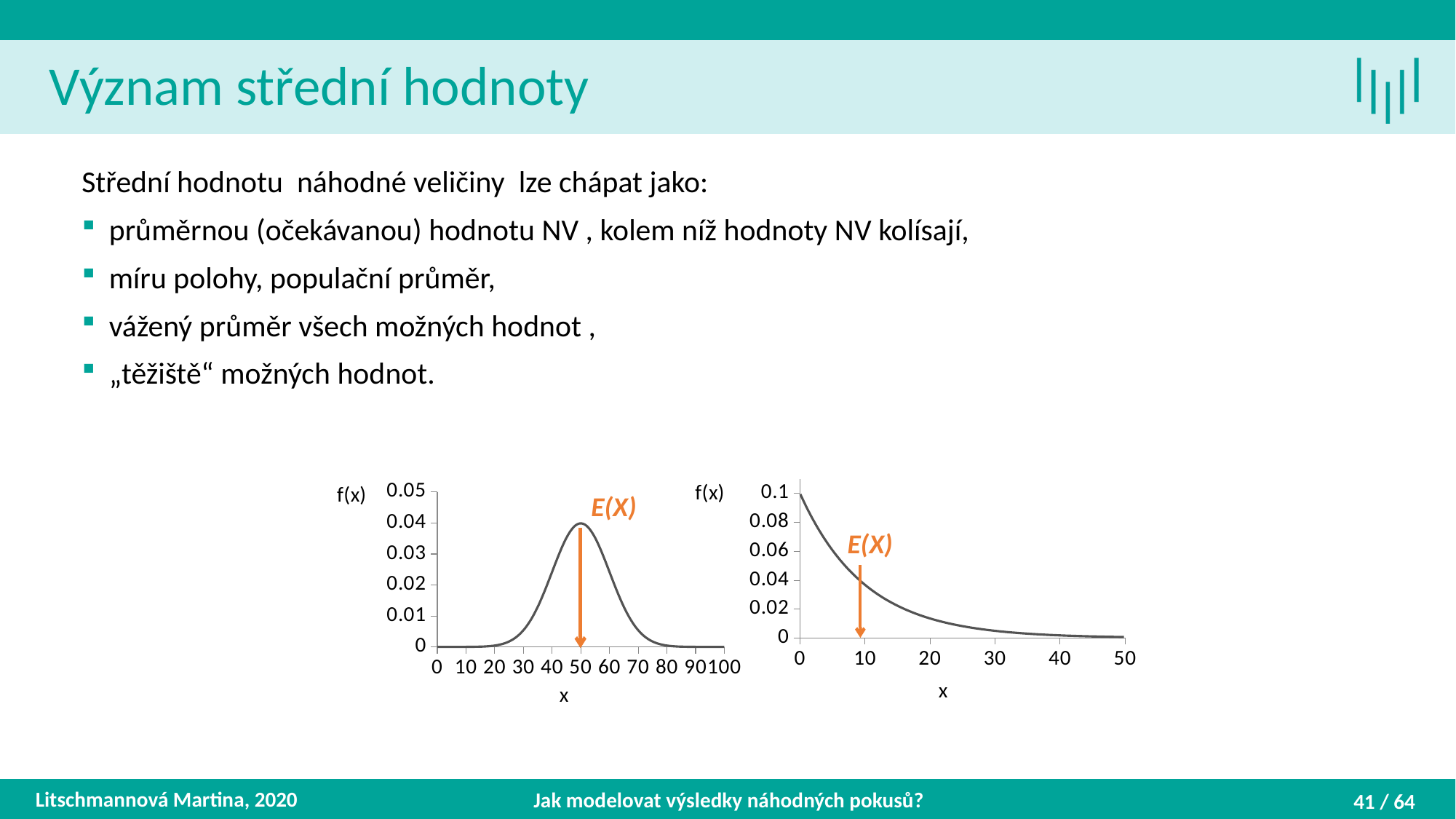
In the right chart, is the value of f(x) at x = 20 greater or less than 0.04? less In the left chart, which is larger: the value of f(x) at x = 50 or at x = 80? x = 50 In the right chart, do the values of f(x) rise or fall as x increases? fall In the right chart, at which value of x does the orange E(X) arrow point? 10 What kind of chart is the left chart on the slide? line chart What kind of chart is the right chart on the slide? line chart In the left chart, at which value of x does the curve reach its highest point? 50 In the right chart, is the value of f(x) at x = 0 greater or less than 0.08? greater In the left chart, is the value of f(x) at x = 50 greater or less than 0.03? greater What label is written next to the orange arrow in each chart? E(X) In the left chart, at which value of x does the orange E(X) arrow point? 50